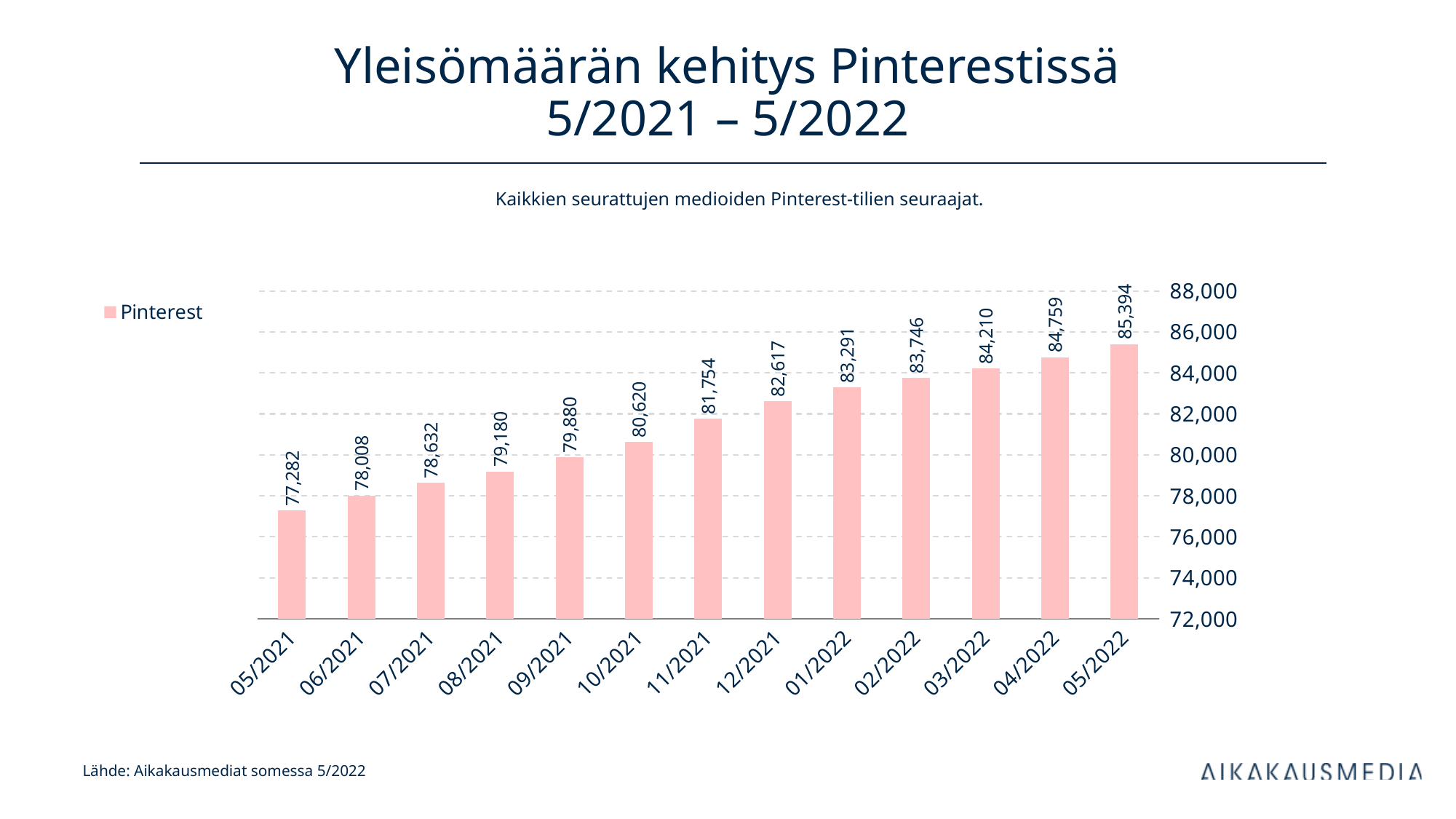
Is the value for 01/2022 greater or less than 82,000? greater What is the difference between the values for 05/2022 and 05/2021? 8,112 What is the value for 03/2022? 84,210 Which month has the highest value? 05/2022 What is the value for 12/2021? 82,617 What kind of chart is shown on the slide? bar chart What is the difference between the values for 10/2021 and 09/2021? 740 What is the value for 05/2021? 77,282 Which is larger, the value for 08/2021 or the value for 11/2021? 11/2021 Do the values rise or fall from 05/2021 to 05/2022? rise Which month has the lowest value? 05/2021 How many months are shown on the x axis? 13